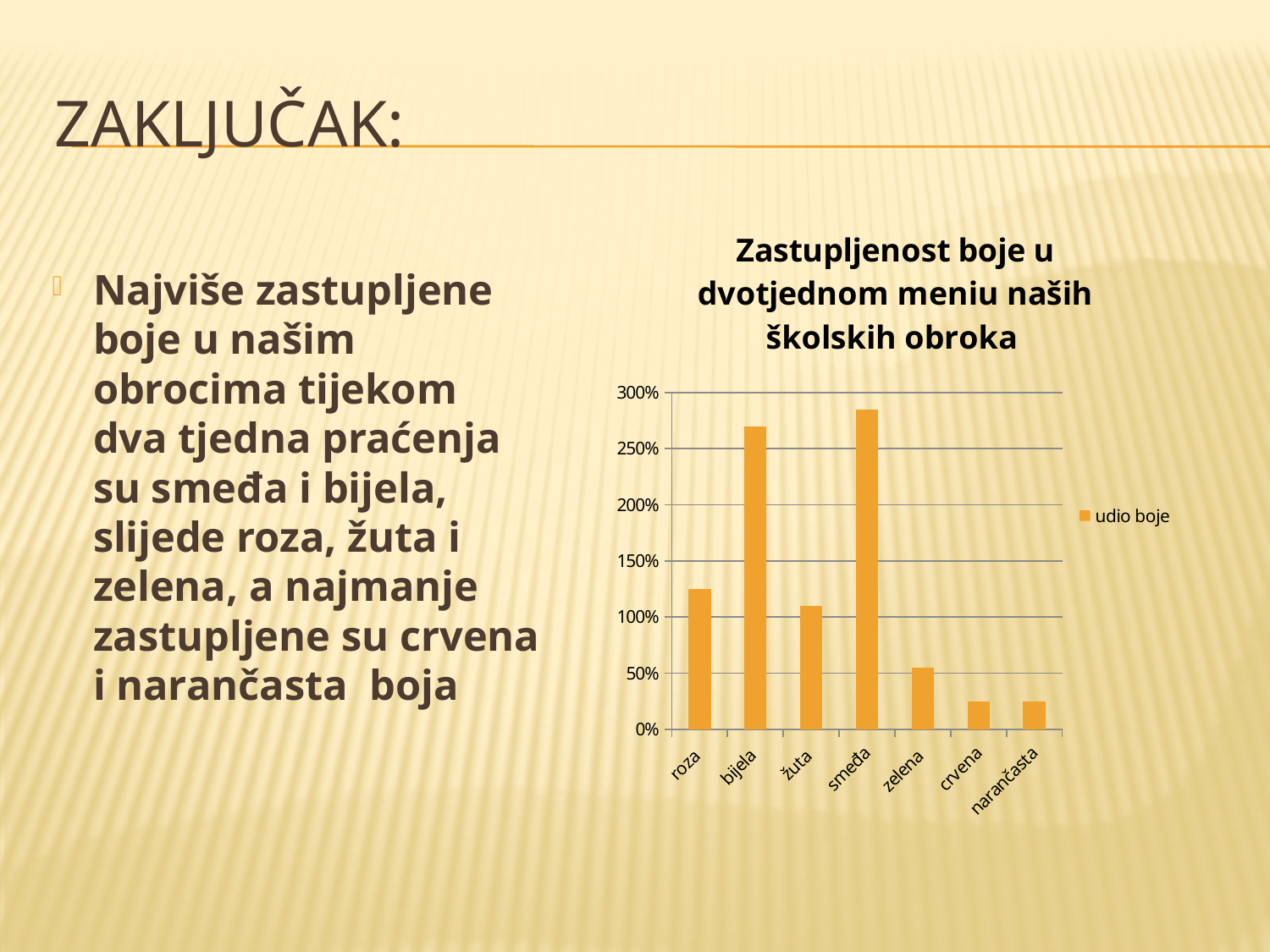
Is the value for bijela greater or less than 250%? greater Is the value for smeđa greater or less than 300%? less How many colour categories are shown on the x axis of the chart? 7 Which has the larger value, roza or zelena? roza What kind of chart is shown on the slide? bar chart Which colour category has the highest bar in the chart? smeđa How many series does the chart legend list? 1 What series name is shown in the chart legend? udio boje Which has the larger value, bijela or žuta? bijela Is the value for roza greater or less than 100%? greater What is the title of the chart? Zastupljenost boje u dvotjednom meniu naših školskih obroka